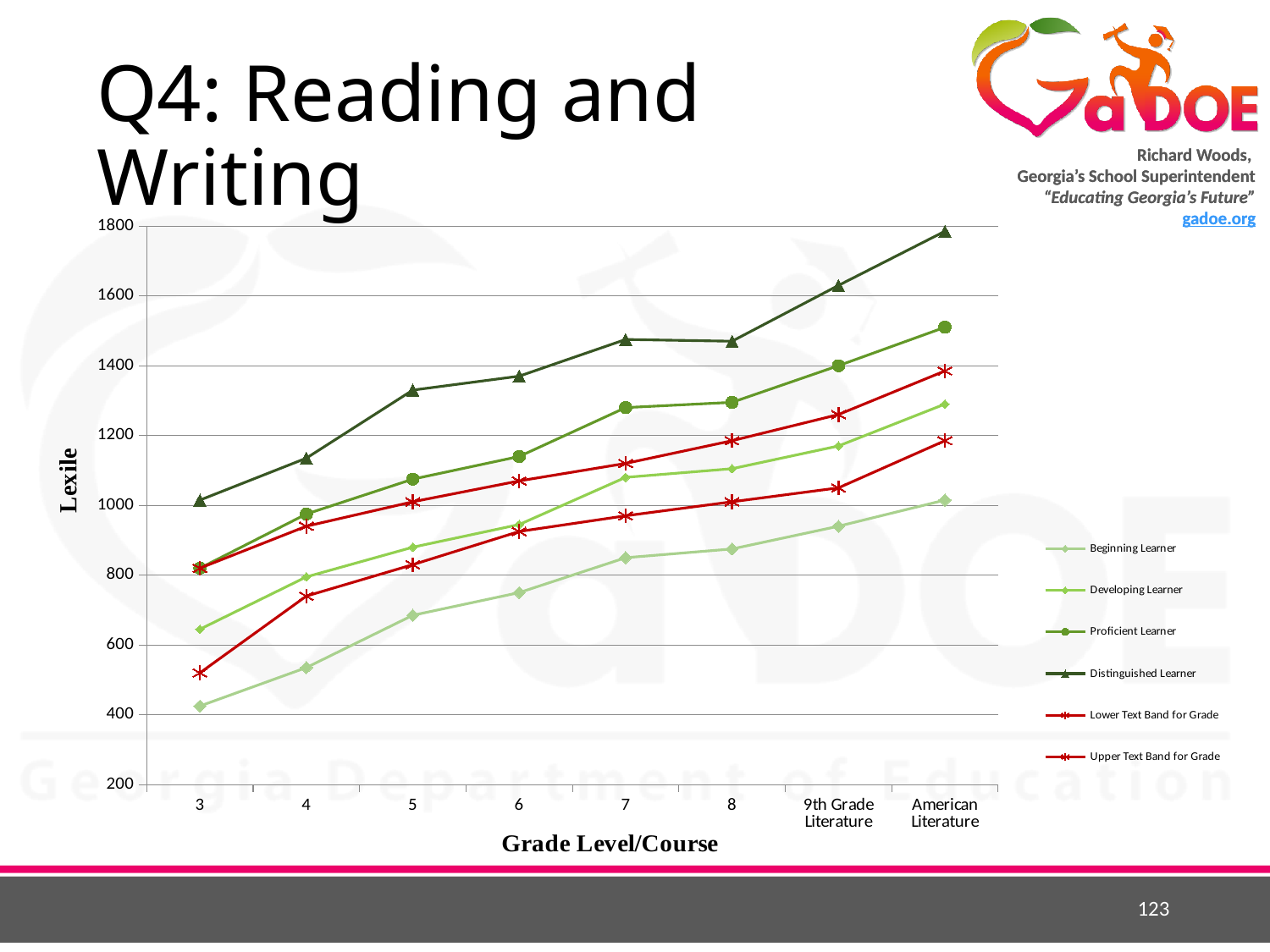
Is the Proficient Learner value at grade 7 greater or less than 1200? greater Does the Distinguished Learner line rise or fall from grade 3 to American Literature? rise What kind of chart is shown on the slide? line chart Is the Beginning Learner value at grade 3 greater or less than 600? less Which series has the lowest value at grade 3? Beginning Learner Which series has the highest value at American Literature? Distinguished Learner At grade 8, which is larger: the Proficient Learner value or the Upper Text Band for Grade value? Proficient Learner How many series does the legend list? 6 Is the Distinguished Learner value at American Literature greater or less than 1600? greater How many grade levels/courses are plotted along the x axis? 8 What is the title of the vertical axis? Lexile